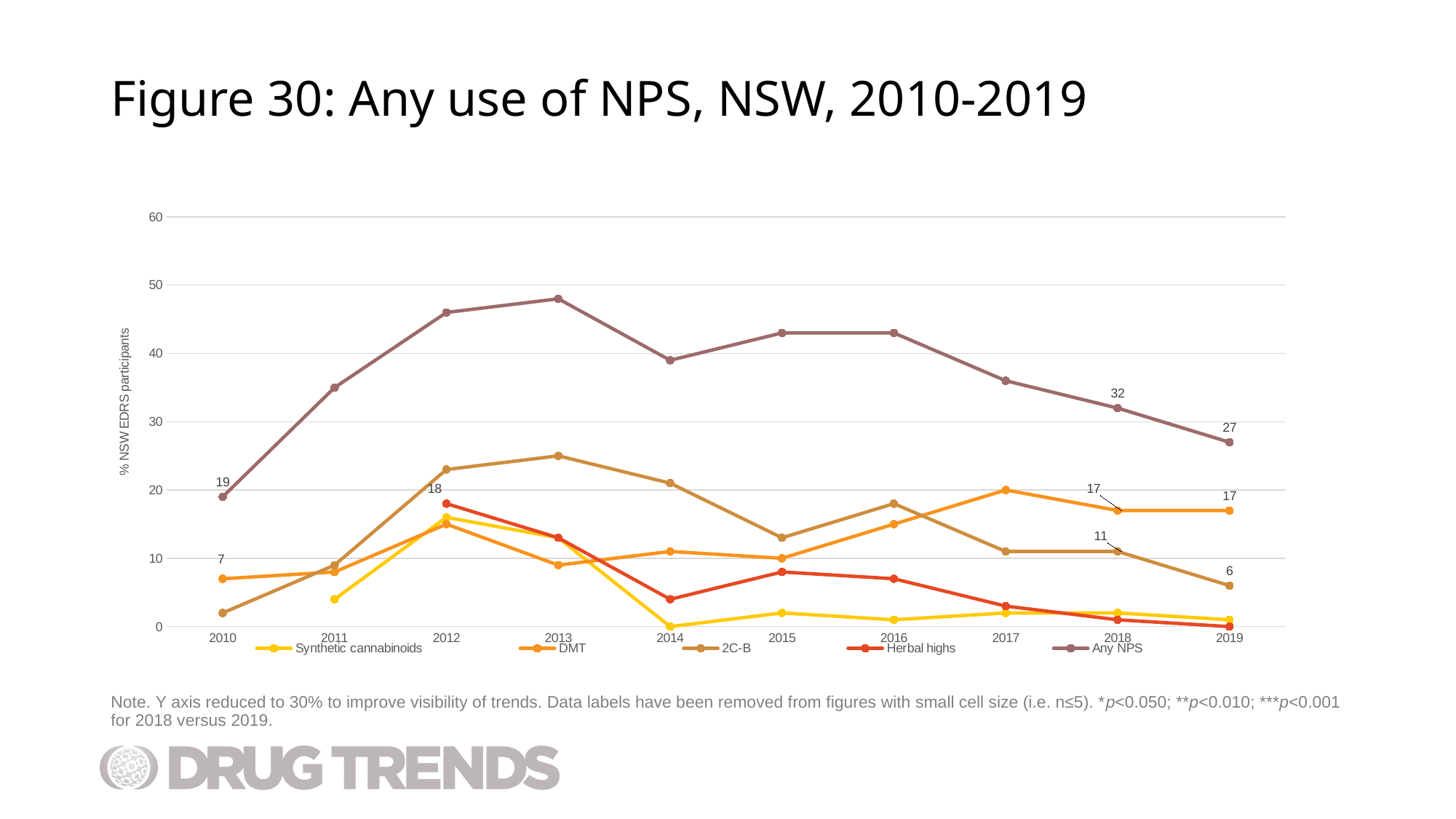
How many years are plotted along the x axis? 10 Which series has the highest value in 2019? Any NPS What is the value for DMT in 2010? 7 Is the value for Any NPS in 2013 greater or less than 40? greater What is the value for 2C-B in 2019? 6 What is the value for Herbal highs in 2012? 18 What is the value for Any NPS in 2019? 27 By how much did the Any NPS value fall from 2018 to 2019? 5 What is the value for Any NPS in 2018? 32 What kind of chart is shown on the slide? line chart Which is larger in 2018, the value for DMT or the value for 2C-B? DMT How many series does the legend list? 5